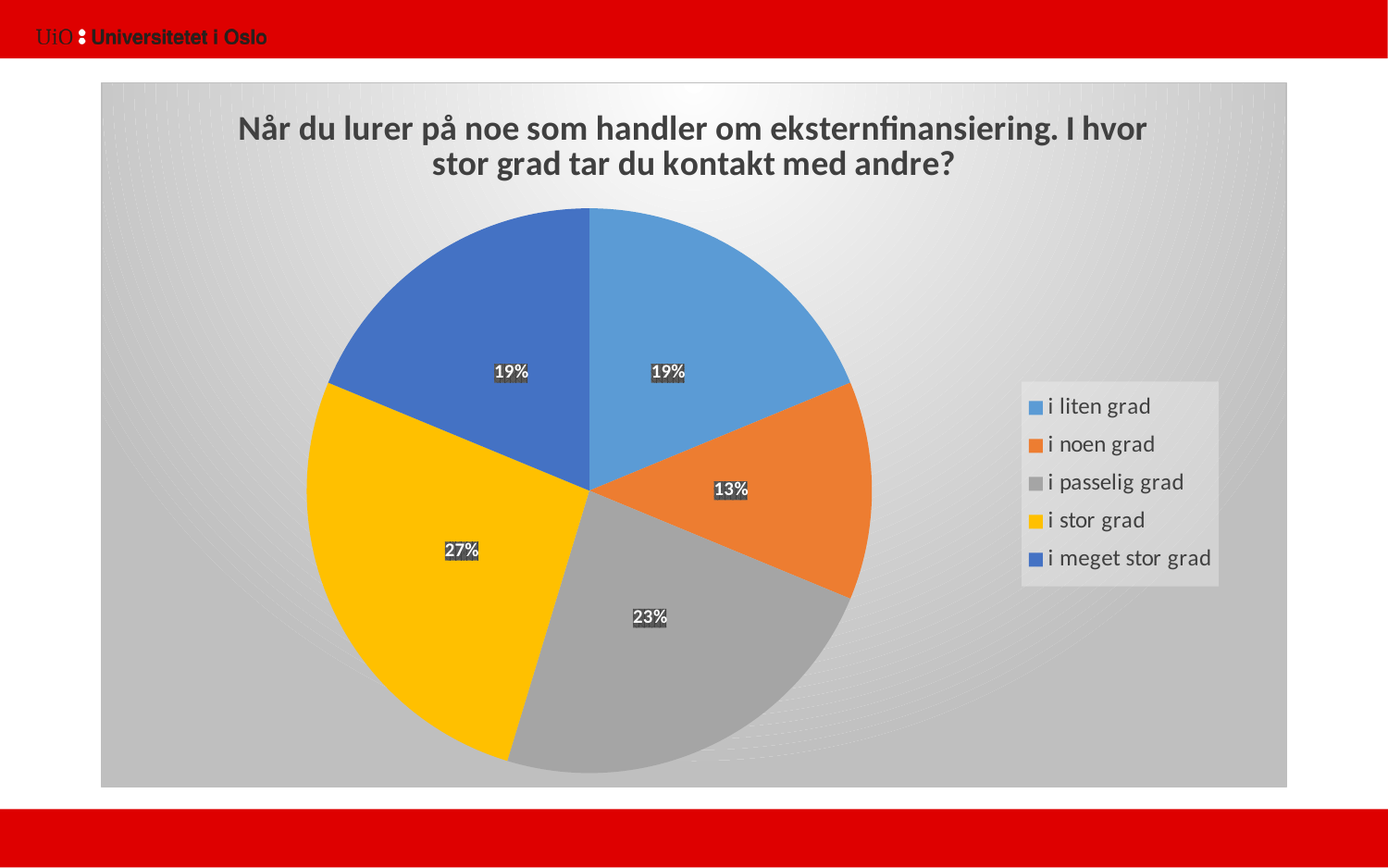
What share of the pie is labelled "i liten grad"? 19% Which category has the largest slice of the pie? i stor grad What kind of chart is shown on the slide? Pie chart What is the difference in percentage points between "i stor grad" and "i noen grad"? 14 Which category has the smallest slice of the pie? i noen grad What share of the pie is labelled "i meget stor grad"? 19% How many categories does the legend list? 5 What colour is the slice for "i stor grad"? Yellow What share of the pie is labelled "i stor grad"? 27% Which is larger, the slice for "i passelig grad" or the slice for "i liten grad"? i passelig grad